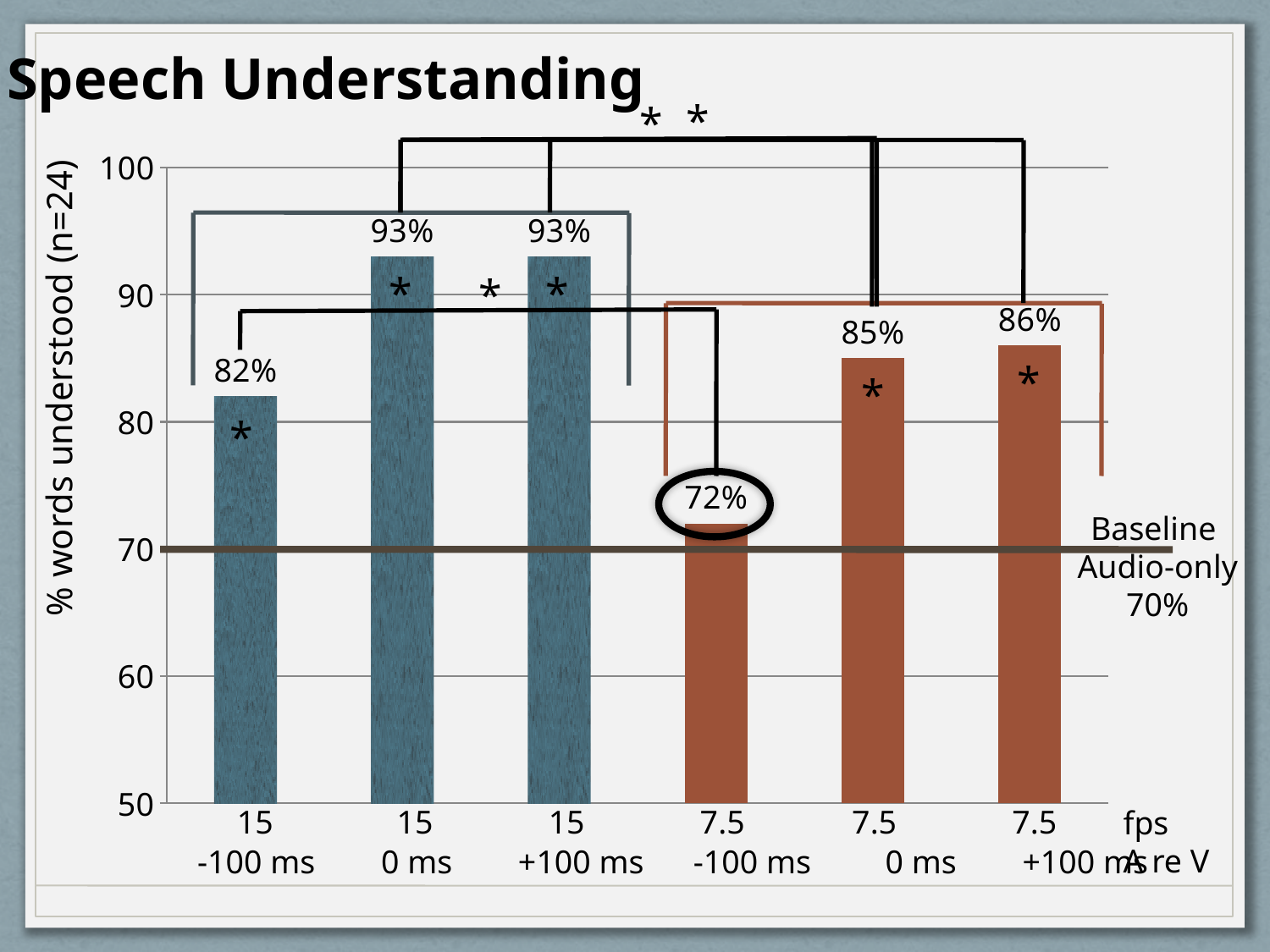
What is the difference between the 15 fps, 0 ms value and the 7.5 fps, -100 ms value? 21% Which condition has the lowest percentage of words understood? 7.5 fps, -100 ms Which is larger, the value for 15 fps, -100 ms or the value for 7.5 fps, 0 ms? 7.5 fps, 0 ms What kind of chart is shown on the slide? bar chart What is the difference between the 7.5 fps, +100 ms value and the 7.5 fps, 0 ms value? 1% What is the value for the 7.5 fps, +100 ms condition? 86% What is the value for the 15 fps, 0 ms condition? 93% What is the value for the 7.5 fps, -100 ms condition? 72% What is the value for the 15 fps, -100 ms condition? 82% What is the title of the chart? Speech Understanding What is the baseline audio-only percentage shown on the chart? 70% How many bars are shown in the chart? 6